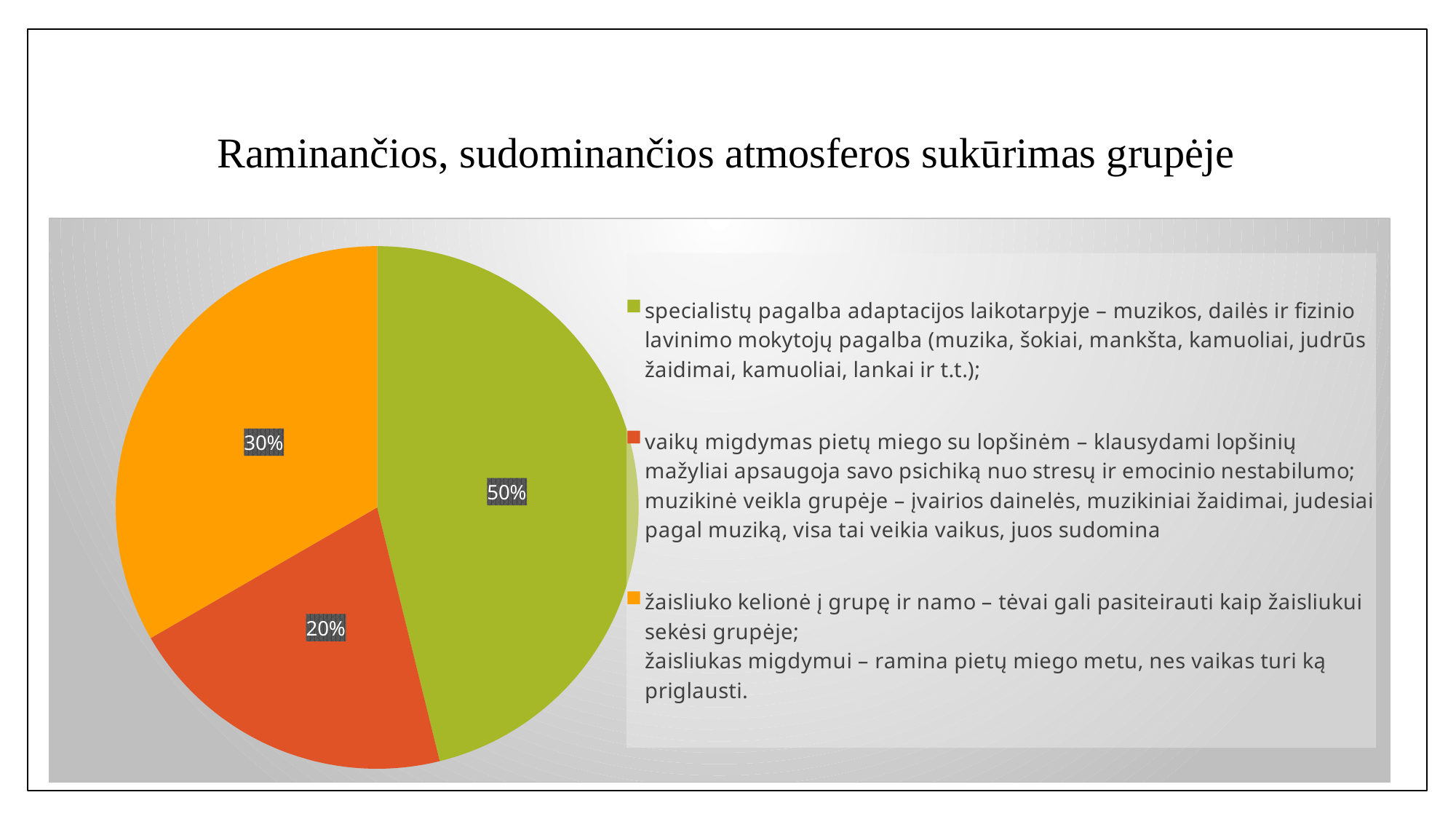
Which legend category has the smallest slice of the pie? vaikų migdymas pietų miego su lopšinėm What is the difference in percentage points between the largest slice and the smallest slice? 30 How many slices does the pie chart have? 3 What share of the pie does the slice for "vaikų migdymas pietų miego su lopšinėm" represent? 20% What share of the pie does the slice for "specialistų pagalba adaptacijos laikotarpyje" represent? 50% What share of the pie does the slice for "žaisliuko kelionė į grupę ir namo" represent? 30% Which is larger: the slice for "žaisliuko kelionė į grupę ir namo" or the slice for "vaikų migdymas pietų miego su lopšinėm"? žaisliuko kelionė į grupę ir namo What is the title of the slide containing the pie chart? Raminančios, sudominančios atmosferos sukūrimas grupėje What colour is the slice labelled 50%? green How many entries does the legend of the pie chart list? 3 Which legend category has the largest slice of the pie? specialistų pagalba adaptacijos laikotarpyje What kind of chart is shown on the slide? pie chart